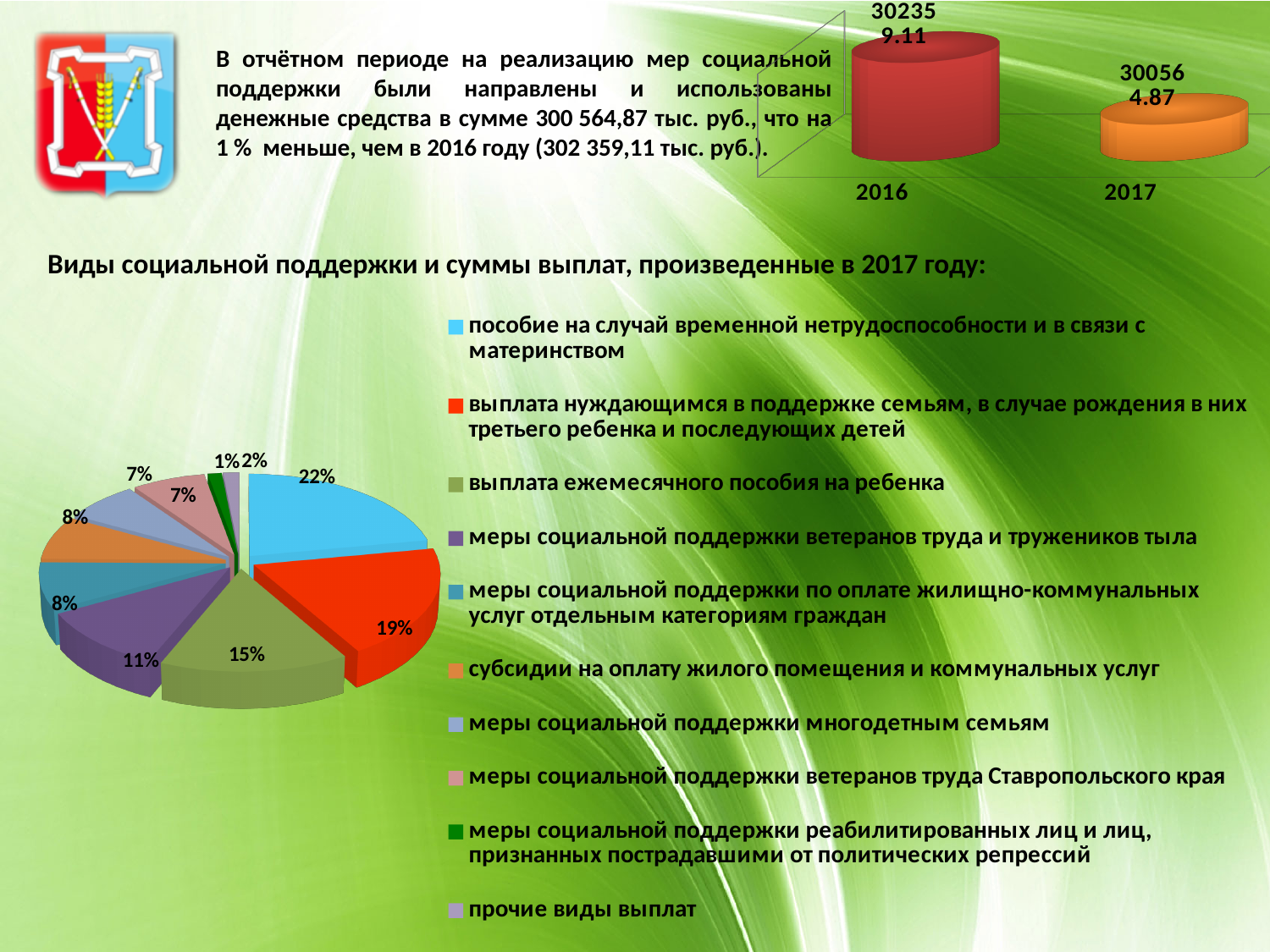
In the pie chart, what share is shown for 'прочие виды выплат'? 2% In the pie chart, what share is shown for 'меры социальной поддержки ветеранов труда и тружеников тыла'? 11% How many categories are shown on the x axis of the chart at the top right of the slide? 2 In the pie chart, which is larger: the share for 'меры социальной поддержки ветеранов труда и тружеников тыла' or the share for 'субсидии на оплату жилого помещения и коммунальных услуг'? меры социальной поддержки ветеранов труда и тружеников тыла In the pie chart, what share is shown for 'пособие на случай временной нетрудоспособности и в связи с материнством'? 22% In the chart at the top right of the slide, which year has the taller bar, 2016 or 2017? 2016 In the pie chart, which category has the smallest share? меры социальной поддержки реабилитированных лиц и лиц, признанных пострадавшими от политических репрессий How many entries does the legend of the pie chart list? 10 In the pie chart, what is the difference in percentage points between the share for 'выплата нуждающимся в поддержке семьям, в случае рождения в них третьего ребенка и последующих детей' and the share for 'выплата ежемесячного пособия на ребенка'? 4 What kind of chart is the chart at the bottom left of the slide? pie chart In the pie chart, which category has the largest share? пособие на случай временной нетрудоспособности и в связи с материнством In the pie chart, what share is shown for 'выплата ежемесячного пособия на ребенка'? 15%